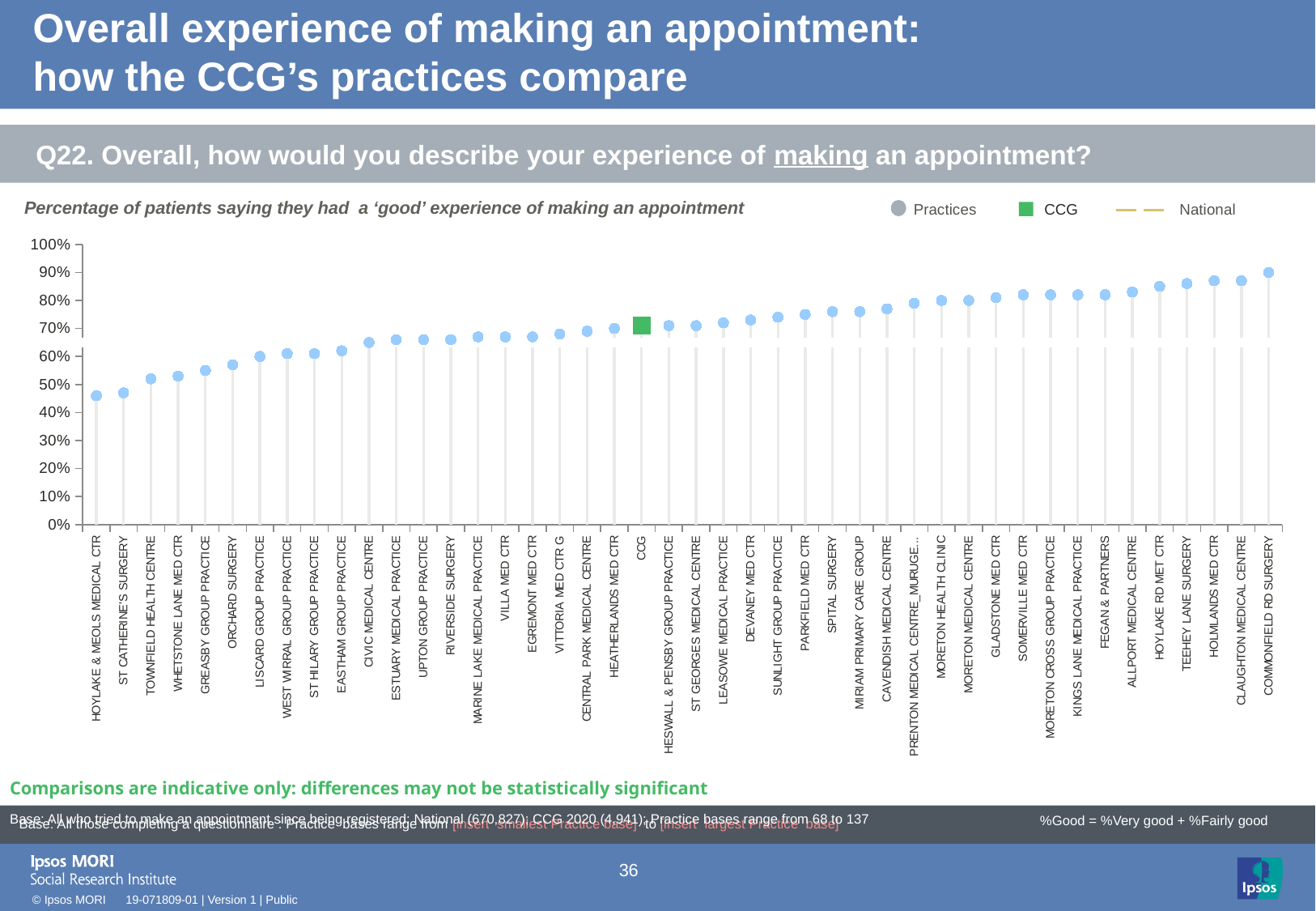
How many entries does the chart legend list? 3 Which practice has the lowest percentage of patients saying they had a 'good' experience of making an appointment? HOYLAKE & MEOLS MEDICAL CTR Is the value for HOYLAKE & MEOLS MEDICAL CTR greater or less than 50%? less Which practice has the highest percentage of patients saying they had a 'good' experience of making an appointment? COMMONFIELD RD SURGERY Is the value for CCG greater or less than 60%? greater Is the value for ORCHARD SURGERY greater or less than 50%? greater Do the values rise or fall moving from left to right along the x axis? rise Which has a higher value, ST CATHERINE'S SURGERY or SPITAL SURGERY? SPITAL SURGERY What colour is the marker used for the CCG in the chart? green What is the subtitle describing what the chart plots? Percentage of patients saying they had a 'good' experience of making an appointment